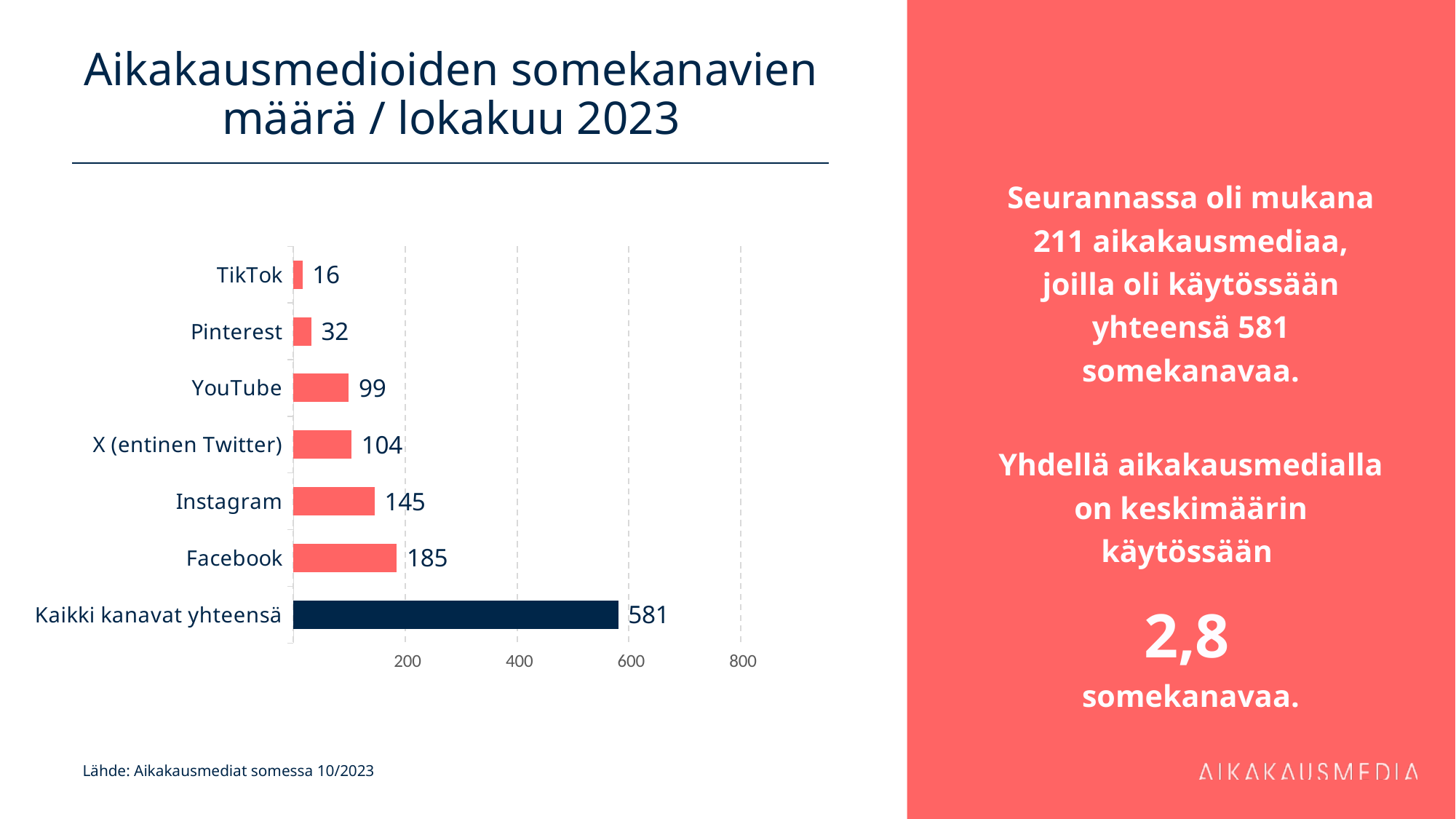
What is the value for Facebook? 185 Which is larger, the value for YouTube or the value for X (entinen Twitter)? X (entinen Twitter) What is the value for TikTok? 16 Which individual channel (excluding the total bar) has the highest value? Facebook Which category has the lowest value? TikTok What kind of chart is shown on the slide? bar chart What is the value for Kaikki kanavat yhteensä? 581 What is the difference between the values for Facebook and Instagram? 40 What is the title of the chart on the slide? Aikakausmedioiden somekanavien määrä / lokakuu 2023 How many categories are shown in the chart? 7 What is the value for X (entinen Twitter)? 104 Is the value for Kaikki kanavat yhteensä greater or less than 600? less